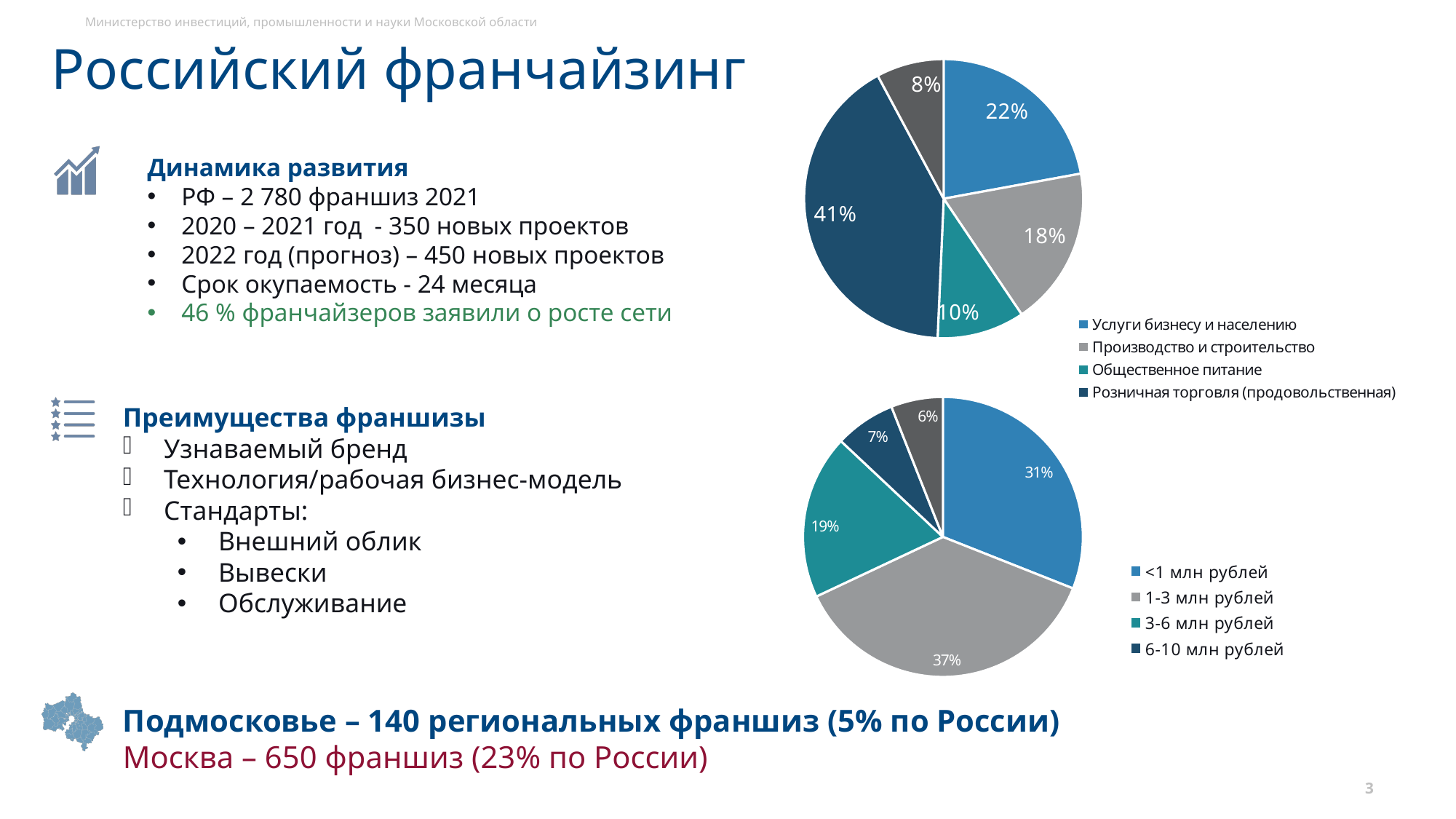
How many entries does the legend of the top pie chart list? 4 In the bottom pie chart, what share does the 6-10 млн рублей category have? 7% How many slices does the bottom pie chart have? 5 In the bottom pie chart, what is the difference between the shares of 1-3 млн рублей and <1 млн рублей? 6% In the bottom pie chart, which legend category has the smallest share? 6-10 млн рублей In the top pie chart, what is the difference between the shares of Услуги бизнесу и населению and Производство и строительство? 4% In the top pie chart, which legend category has the largest share? Розничная торговля (продовольственная) In the top pie chart, what share does Розничная торговля (продовольственная) have? 41% In the top pie chart, what share does Общественное питание have? 10% In the bottom pie chart, which is larger: the share for <1 млн рублей or the share for 3-6 млн рублей? <1 млн рублей In the bottom pie chart, what share does the 1-3 млн рублей category have? 37% What type of chart is the top chart on the right side of the slide? pie chart